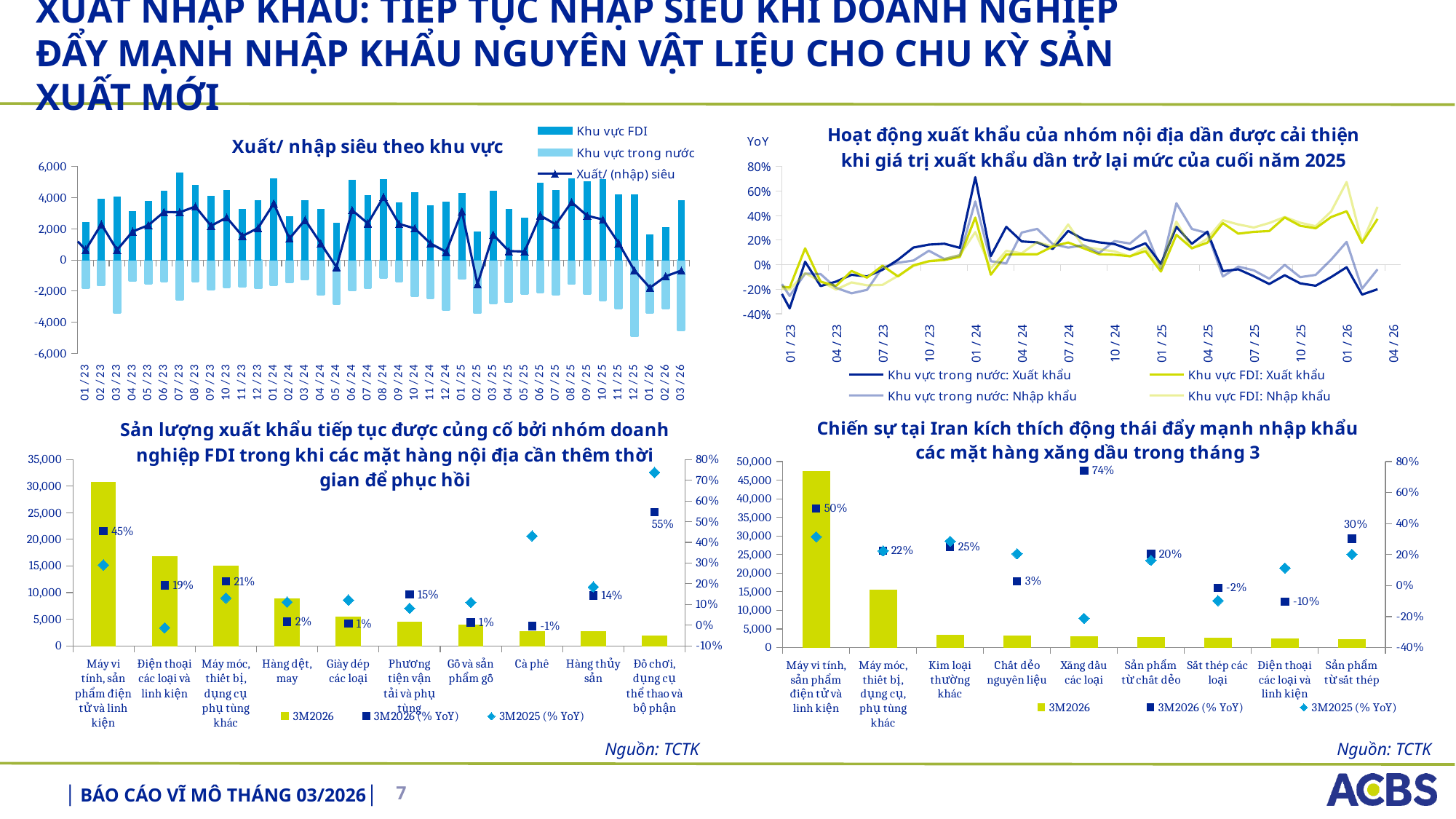
In the bottom-right chart (Chiến sự tại Iran kích thích...), what is the 3M2026 (% YoY) value for Xăng dầu các loại? 74% How many series does the legend of the top-right chart (Hoạt động xuất khẩu của nhóm nội địa...) list? 4 How many categories are shown on the x axis of the bottom-left chart (Sản lượng xuất khẩu tiếp tục được củng cố...)? 10 In the bottom-right chart (Chiến sự tại Iran kích thích...), what is the difference between the 3M2026 (% YoY) values for Máy vi tính, sản phẩm điện tử và linh kiện and Máy móc, thiết bị, dụng cụ, phụ tùng khác? 28 percentage points How many series does the legend of the top-left chart (Xuất/ nhập siêu theo khu vực) list? 3 In the bottom-right chart (Chiến sự tại Iran kích thích...), which category has the lowest 3M2026 (% YoY) value? Điện thoại các loại và linh kiện In the bottom-right chart (Chiến sự tại Iran kích thích...), is the 3M2026 bar for Máy vi tính, sản phẩm điện tử và linh kiện greater or less than 40,000? greater How many categories are shown on the x axis of the bottom-right chart (Chiến sự tại Iran kích thích...)? 9 In the bottom-left chart (Sản lượng xuất khẩu tiếp tục được củng cố...), what is the 3M2026 (% YoY) value for Máy vi tính, sản phẩm điện tử và linh kiện? 45% In the bottom-left chart (Sản lượng xuất khẩu tiếp tục được củng cố...), which category has the highest 3M2026 (% YoY) value? Đồ chơi, dụng cụ thể thao và bộ phận In the bottom-left chart (Sản lượng xuất khẩu tiếp tục được củng cố...), which has the larger 3M2026 (% YoY) value: Điện thoại các loại và linh kiện or Máy móc, thiết bị, dụng cụ phụ tùng khác? Máy móc, thiết bị, dụng cụ phụ tùng khác What kind of chart is the top-right chart (Hoạt động xuất khẩu của nhóm nội địa...)? Line chart